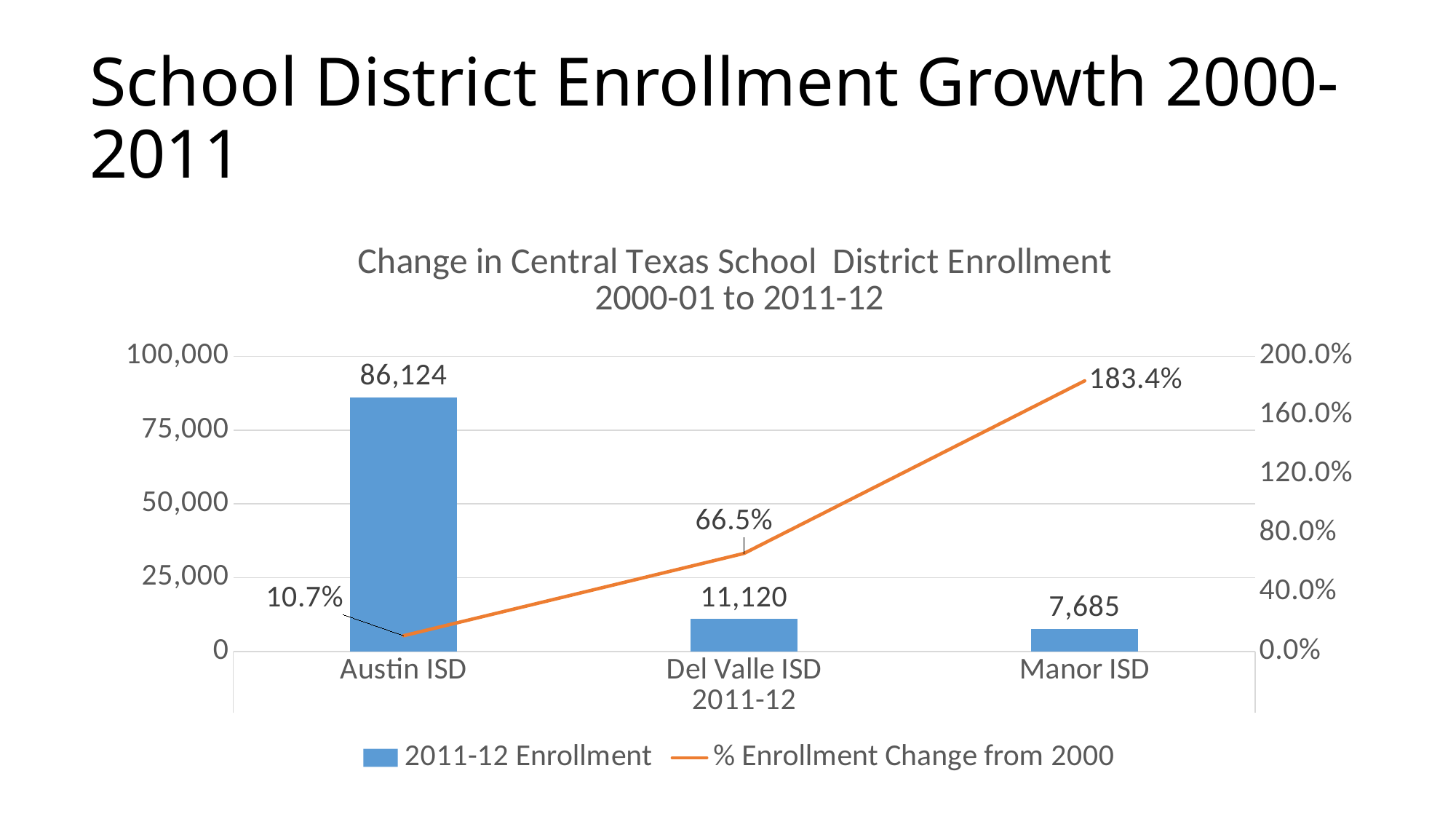
How many series does the legend list? 2 What is the 2011-12 Enrollment for Del Valle ISD? 11,120 What is the % Enrollment Change from 2000 for Austin ISD? 10.7% Which district has the lowest % Enrollment Change from 2000? Austin ISD How many school districts are shown on the chart? 3 What is the % Enrollment Change from 2000 for Manor ISD? 183.4% What is the 2011-12 Enrollment for Manor ISD? 7,685 What is the 2011-12 Enrollment for Austin ISD? 86,124 What is the difference in 2011-12 Enrollment between Del Valle ISD and Manor ISD? 3,435 Which has a larger % Enrollment Change from 2000, Del Valle ISD or Manor ISD? Manor ISD Does the % Enrollment Change from 2000 line rise or fall from Austin ISD to Manor ISD? rise Which district has the highest 2011-12 Enrollment? Austin ISD